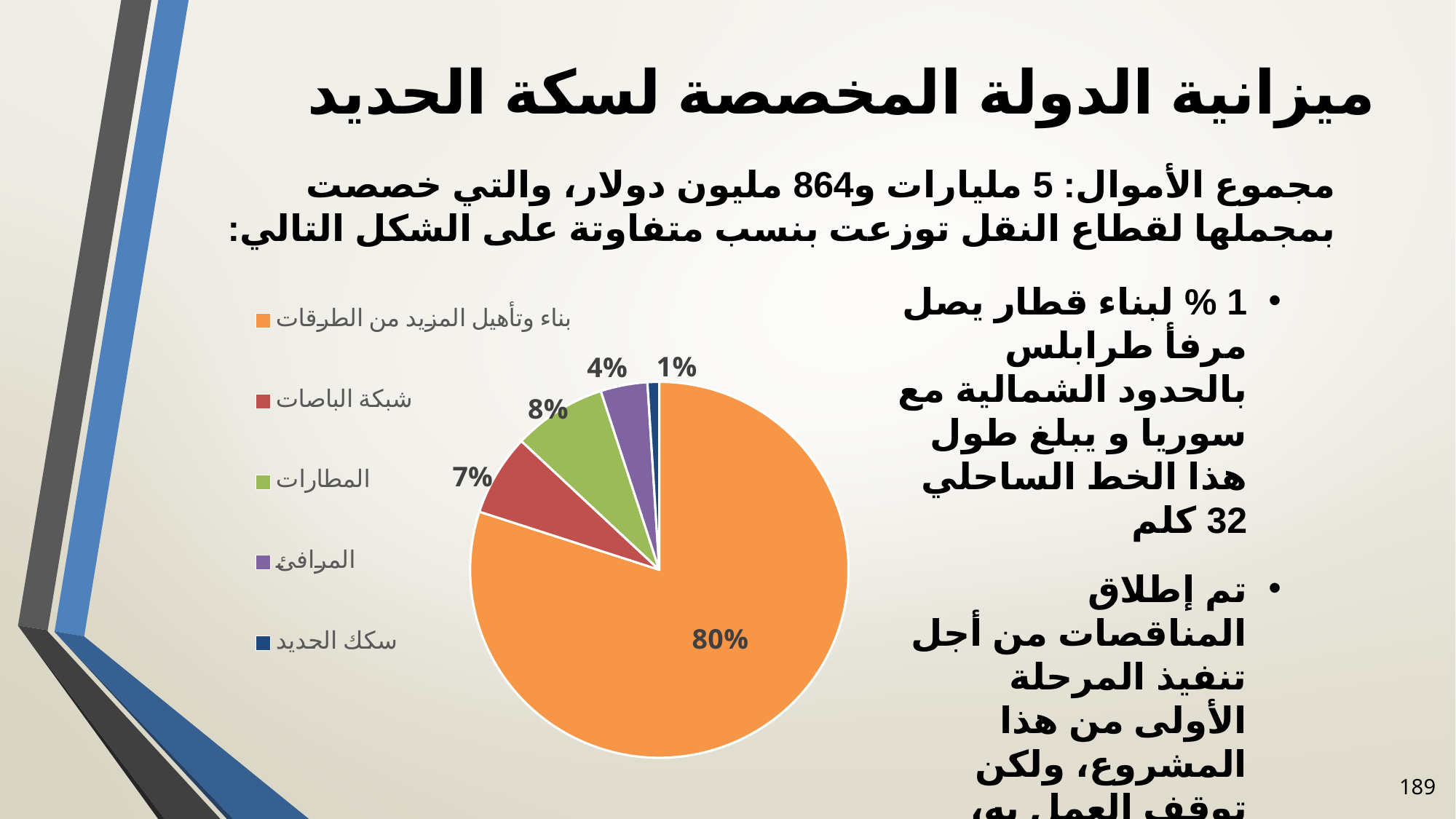
Which category has the smallest slice of the pie? سكك الحديد What share of the pie does سكك الحديد have? 1% What share of the pie does شبكة الباصات have? 7% What share of the pie does المرافئ have? 4% Which category has the largest slice of the pie? بناء وتأهيل المزيد من الطرقات How many categories does the legend of the pie chart list? 5 What colour is the slice for بناء وتأهيل المزيد من الطرقات? orange What share of the pie does المطارات have? 8% Which is larger, the share for المرافئ or the share for سكك الحديد? المرافئ What share of the pie does بناء وتأهيل المزيد من الطرقات have? 80% What kind of chart is shown on the slide? pie chart What is the difference between the shares of المطارات and شبكة الباصات? 1%